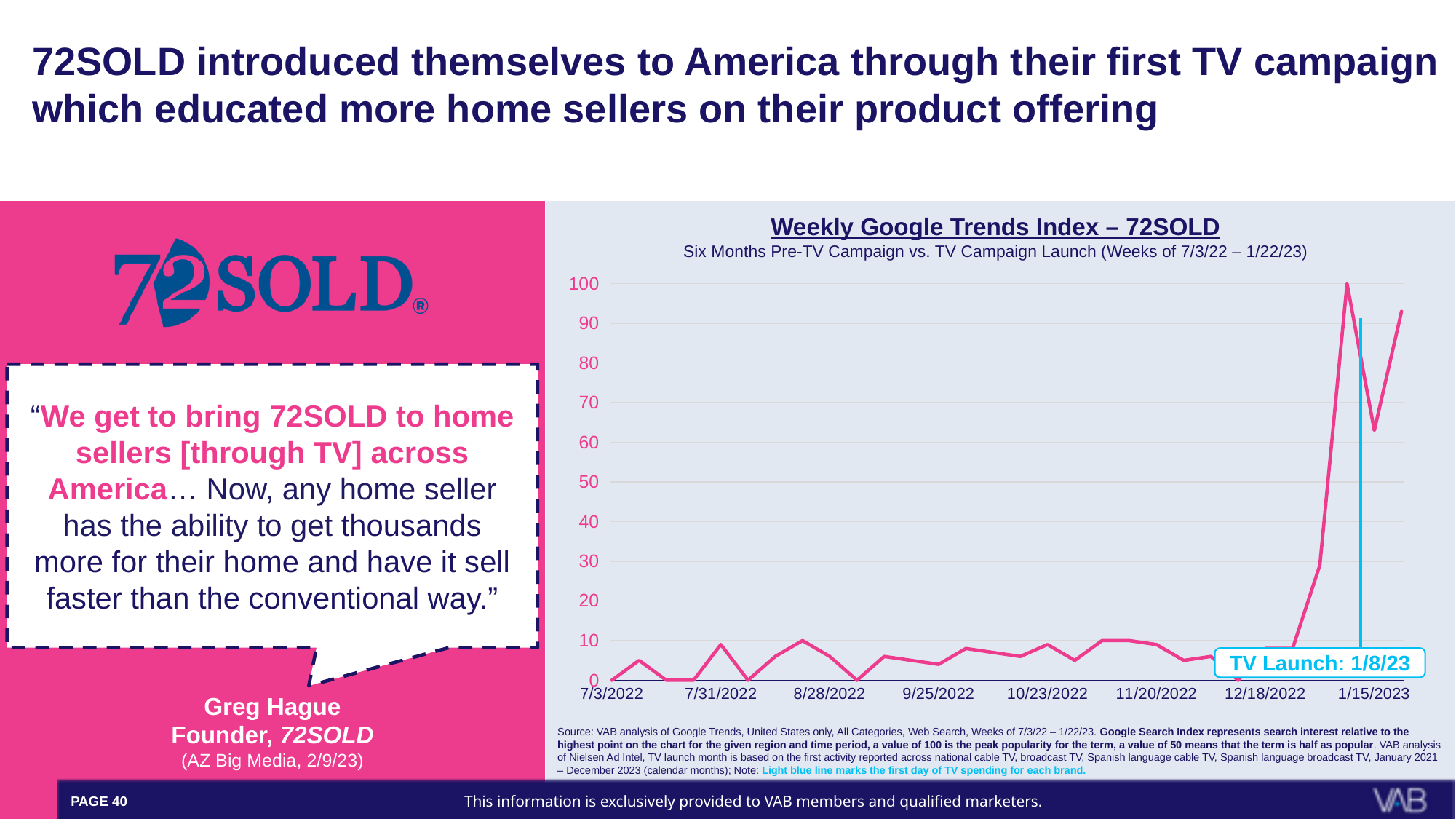
What is the title of the chart? Weekly Google Trends Index – 72SOLD What is the highest value the Google Trends index reaches on the chart? 100 Does the index rise or fall between the week of 12/18/2022 and the peak of the chart? rise Is the index value for the week of 7/3/2022 greater or less than 10? less Which week has the larger index value, 7/3/2022 or 1/15/2023? 1/15/2023 Is the index value for the week of 10/23/2022 greater or less than 20? less What kind of chart is shown on the slide? line chart What TV launch date is called out in the annotation on the chart? 1/8/23 Is the index value for the week of 12/18/2022 greater or less than 20? less How many date labels are shown on the x axis? 8